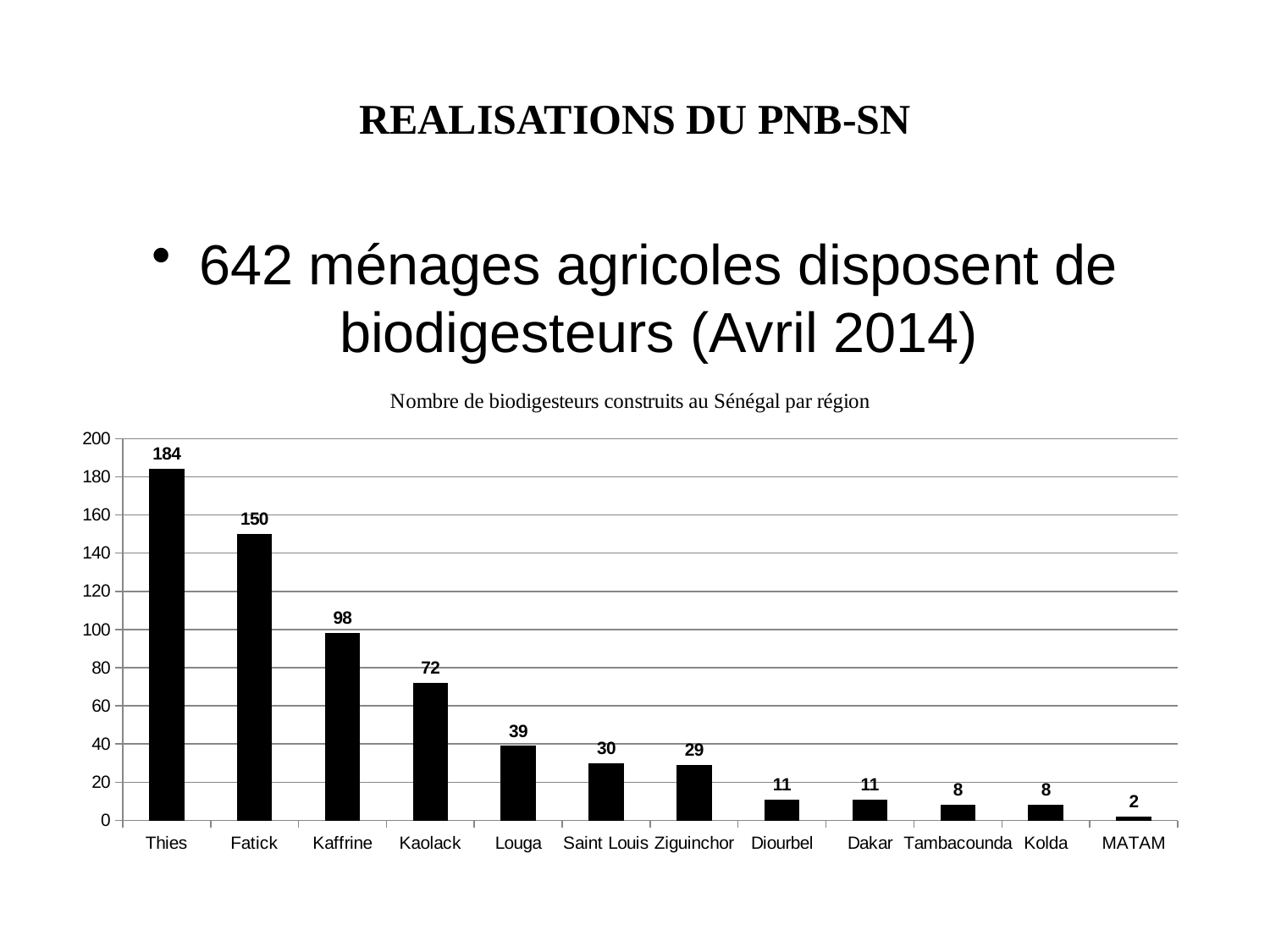
What is the title of the chart? Nombre de biodigesteurs construits au Sénégal par région How many regions are shown on the x axis? 12 Do the values rise or fall from left to right along the x axis? fall What is the difference between the values for Thies and Fatick? 34 Which is larger, the value for Saint Louis or the value for Diourbel? Saint Louis What is the difference between the values for Kaolack and Louga? 33 Which region has the lowest number of biodigesteurs? MATAM What kind of chart is this? bar chart What is the value shown for Kaffrine? 98 What is the number of biodigesteurs for Thies? 184 Which region has the highest number of biodigesteurs? Thies What is the value shown for Ziguinchor? 29